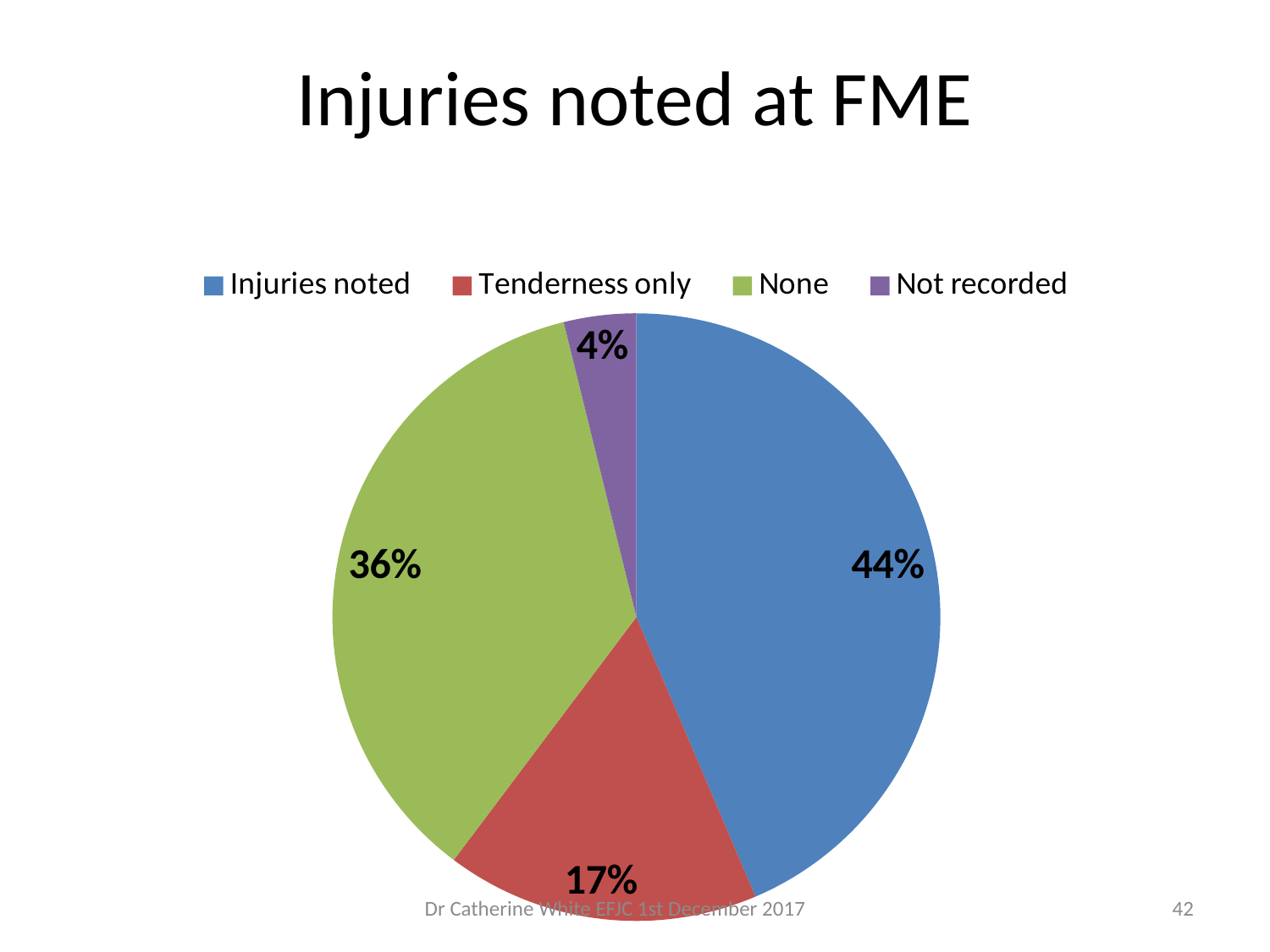
Which is larger, the share for 'Tenderness only' or the share for 'None'? None Which category has the largest share of the pie? Injuries noted What is the difference in percentage points between 'Injuries noted' and 'None'? 8 Which category has the smallest share of the pie? Not recorded What percentage of the pie is 'Tenderness only'? 17% How many categories does the pie chart have? 4 What is the title of the chart? Injuries noted at FME What percentage of the pie is 'Not recorded'? 4% What percentage of the pie is 'Injuries noted'? 44% What kind of chart is shown on the slide? pie chart What percentage of the pie is 'None'? 36% What colour is the 'None' slice? green